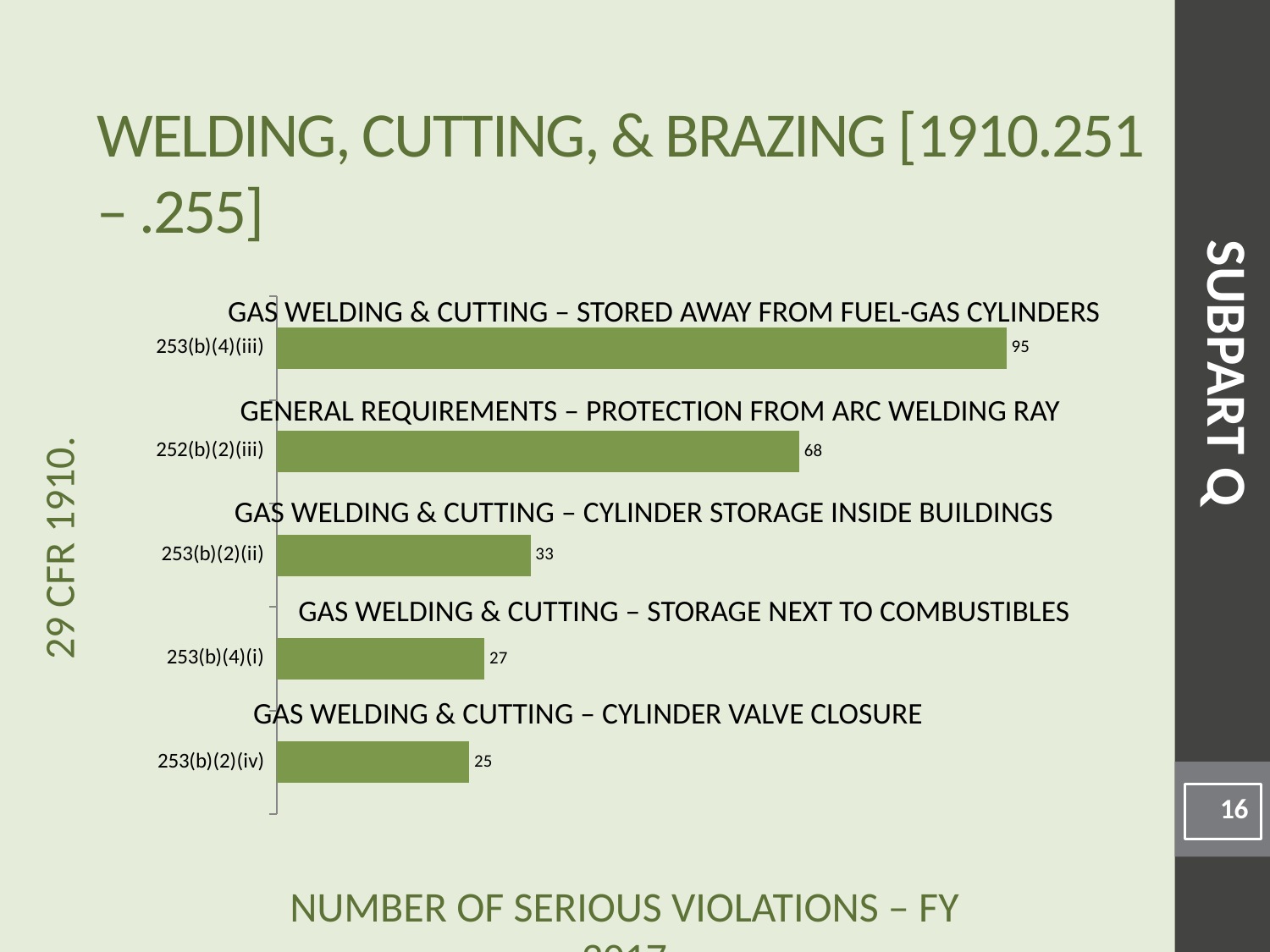
What is the number of serious violations for 253(b)(2)(ii)? 33 Which category has the highest number of serious violations? 253(b)(4)(iii) What is the difference between the values for 253(b)(4)(iii) and 252(b)(2)(iii)? 27 What is the number of serious violations for 253(b)(2)(iv)? 25 What kind of chart is shown on the slide? Bar chart What is the number of serious violations for 252(b)(2)(iii)? 68 Which has more serious violations, 253(b)(2)(ii) or 253(b)(4)(i)? 253(b)(2)(ii) How many categories are shown in the chart? 5 Which description is given for the bar labelled 252(b)(2)(iii)? GENERAL REQUIREMENTS – PROTECTION FROM ARC WELDING RAY What is the number of serious violations for 253(b)(4)(iii)? 95 What is the difference between the values for 253(b)(4)(i) and 253(b)(2)(iv)? 2 Which category has the lowest number of serious violations? 253(b)(2)(iv)